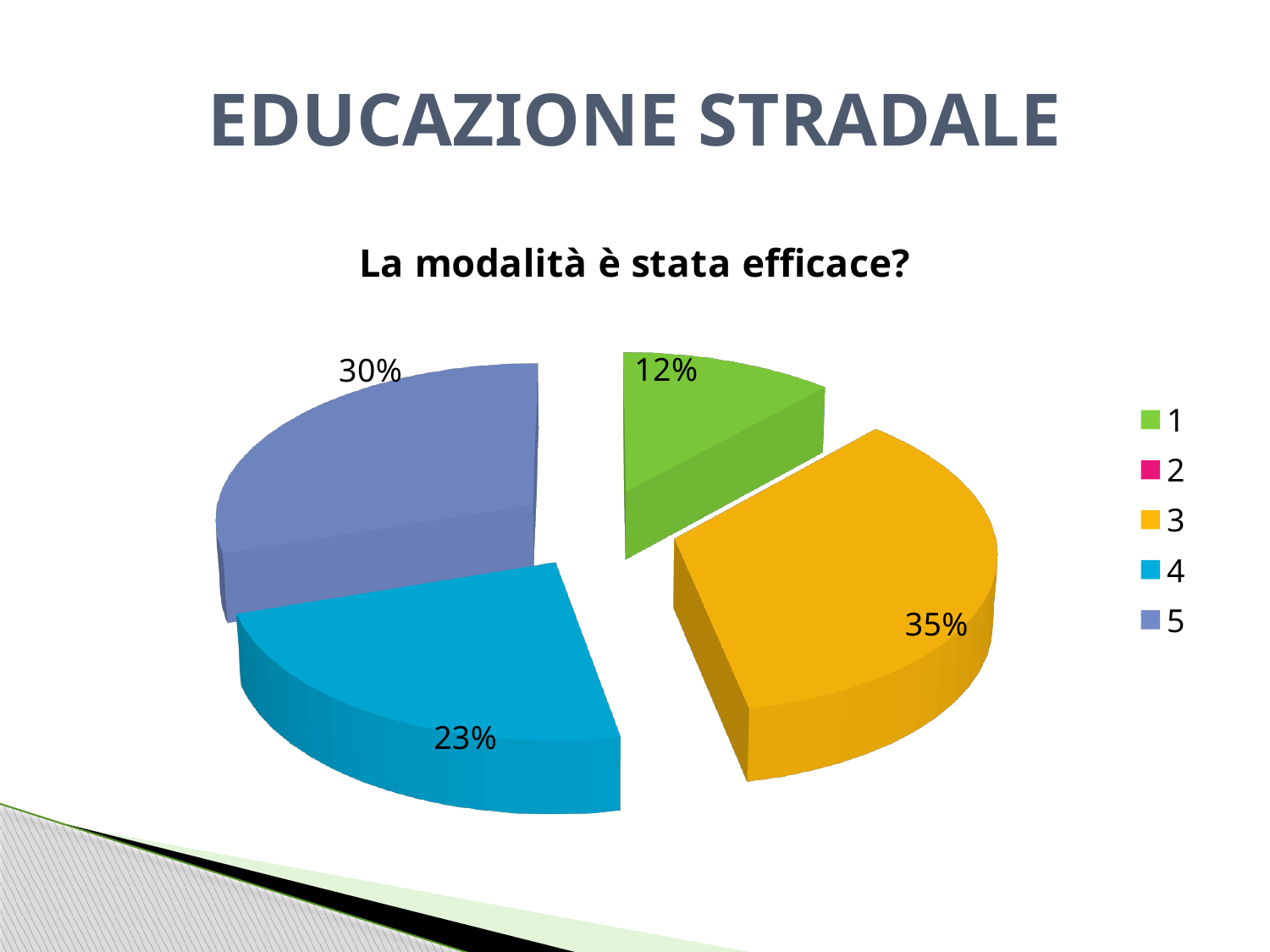
What is the difference in percentage points between category 3 and category 1? 23 What percentage is shown for category 4? 23% What percentage is shown for category 5? 30% Which labelled slice is the smallest? 1 What kind of chart is shown on the slide? pie chart How many entries does the legend list? 5 What percentage is shown for category 3? 35% Which category has the largest slice of the pie? 3 What percentage is shown for category 1? 12% Which is larger, the slice for category 5 or the slice for category 4? 5 What colour is the slice for category 4? blue What is the chart's title? La modalità è stata efficace?